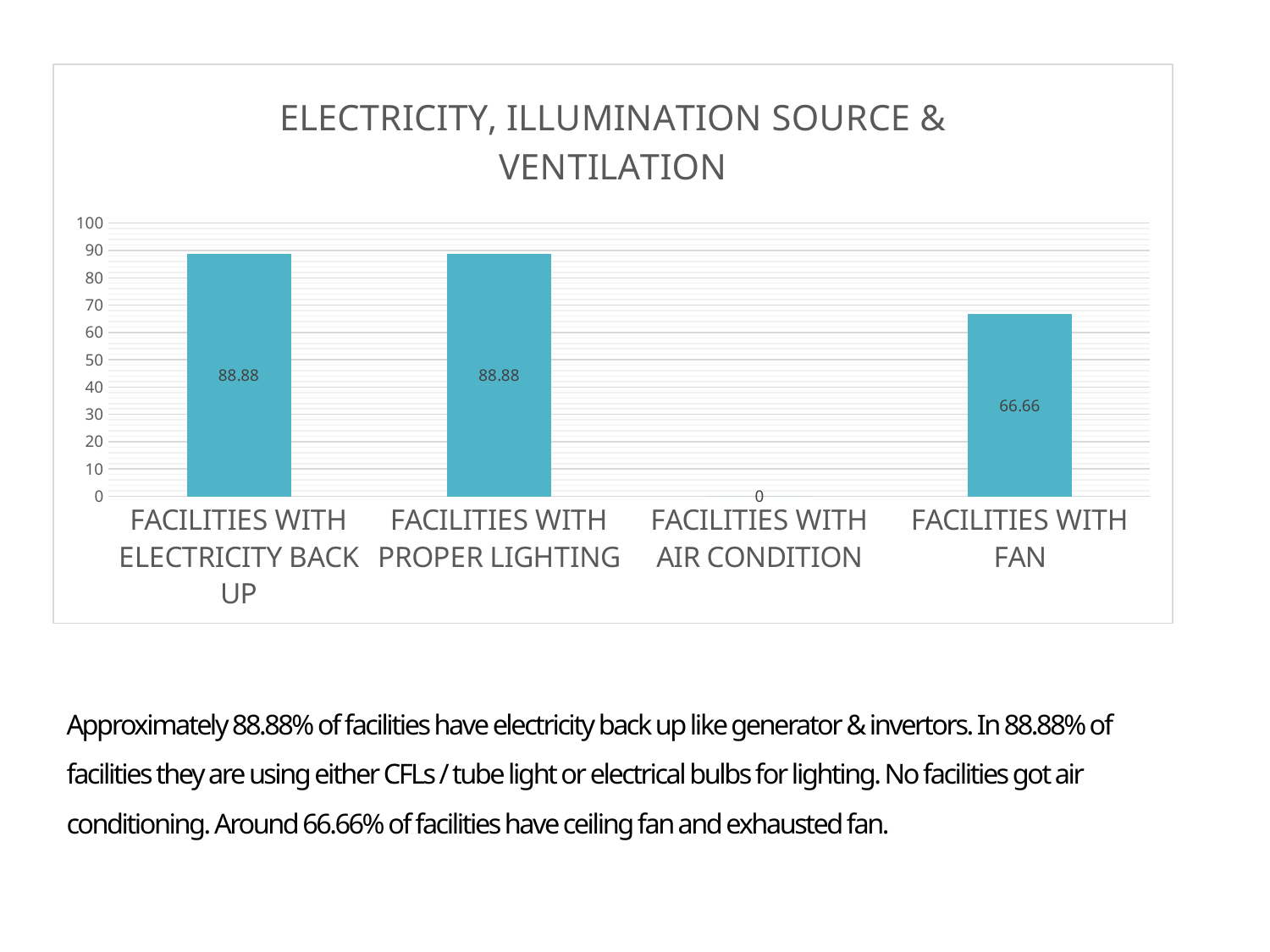
Is the value for Facilities with Proper Lighting greater or less than 80? greater What kind of chart is shown on the slide? Bar chart Which is larger: the value for Facilities with Electricity Back Up or the value for Facilities with Fan? Facilities with Electricity Back Up Is the value for Facilities with Fan greater or less than 70? less What is the value for Facilities with Fan? 66.66 What is the difference between the values for Facilities with Proper Lighting and Facilities with Fan? 22.22 What is the value for Facilities with Electricity Back Up? 88.88 What is the value for Facilities with Proper Lighting? 88.88 Which category has the lowest value? Facilities with Air Condition What is the value for Facilities with Air Condition? 0 What is the title of the chart? Electricity, Illumination Source & Ventilation How many categories are shown on the x axis? 4